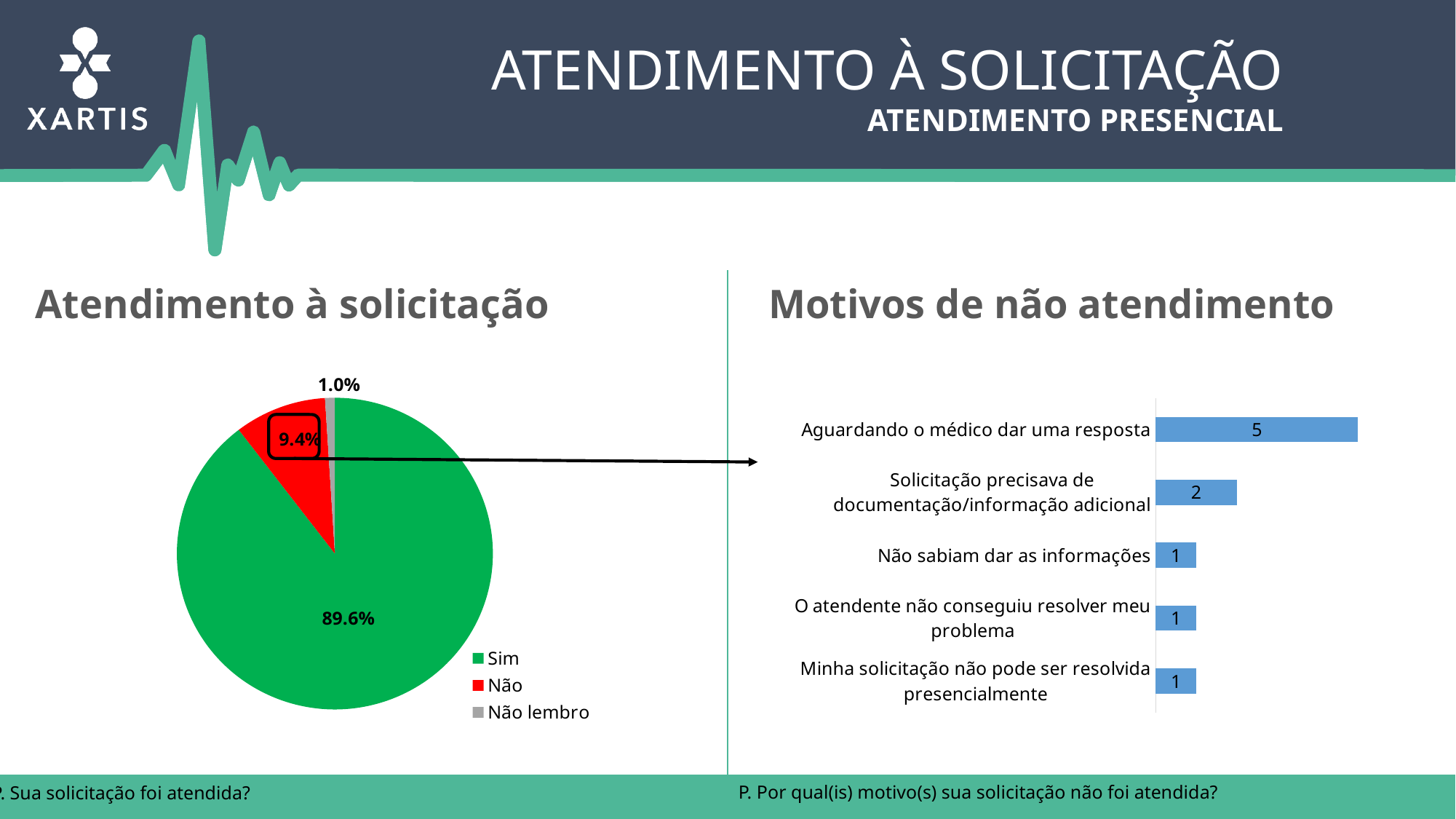
In the 'Motivos de não atendimento' chart, how many categories are shown? 5 In the 'Atendimento à solicitação' pie chart, which category has the smallest slice? Não lembro In the 'Motivos de não atendimento' chart, what is the value for 'Solicitação precisava de documentação/informação adicional'? 2 What kind of chart is the 'Motivos de não atendimento' chart? Bar chart In the 'Atendimento à solicitação' pie chart, what percentage is shown for 'Sim'? 89.6% In the 'Atendimento à solicitação' pie chart, which category has the largest slice? Sim In the 'Atendimento à solicitação' pie chart, how many entries does the legend list? 3 In the 'Motivos de não atendimento' chart, what is the value for 'Aguardando o médico dar uma resposta'? 5 In the 'Motivos de não atendimento' chart, what is the difference between 'Aguardando o médico dar uma resposta' and 'Não sabiam dar as informações'? 4 In the 'Atendimento à solicitação' pie chart, what percentage is shown for 'Não lembro'? 1.0% In the 'Atendimento à solicitação' pie chart, what percentage is shown for 'Não'? 9.4% What kind of chart is the 'Atendimento à solicitação' chart? Pie chart